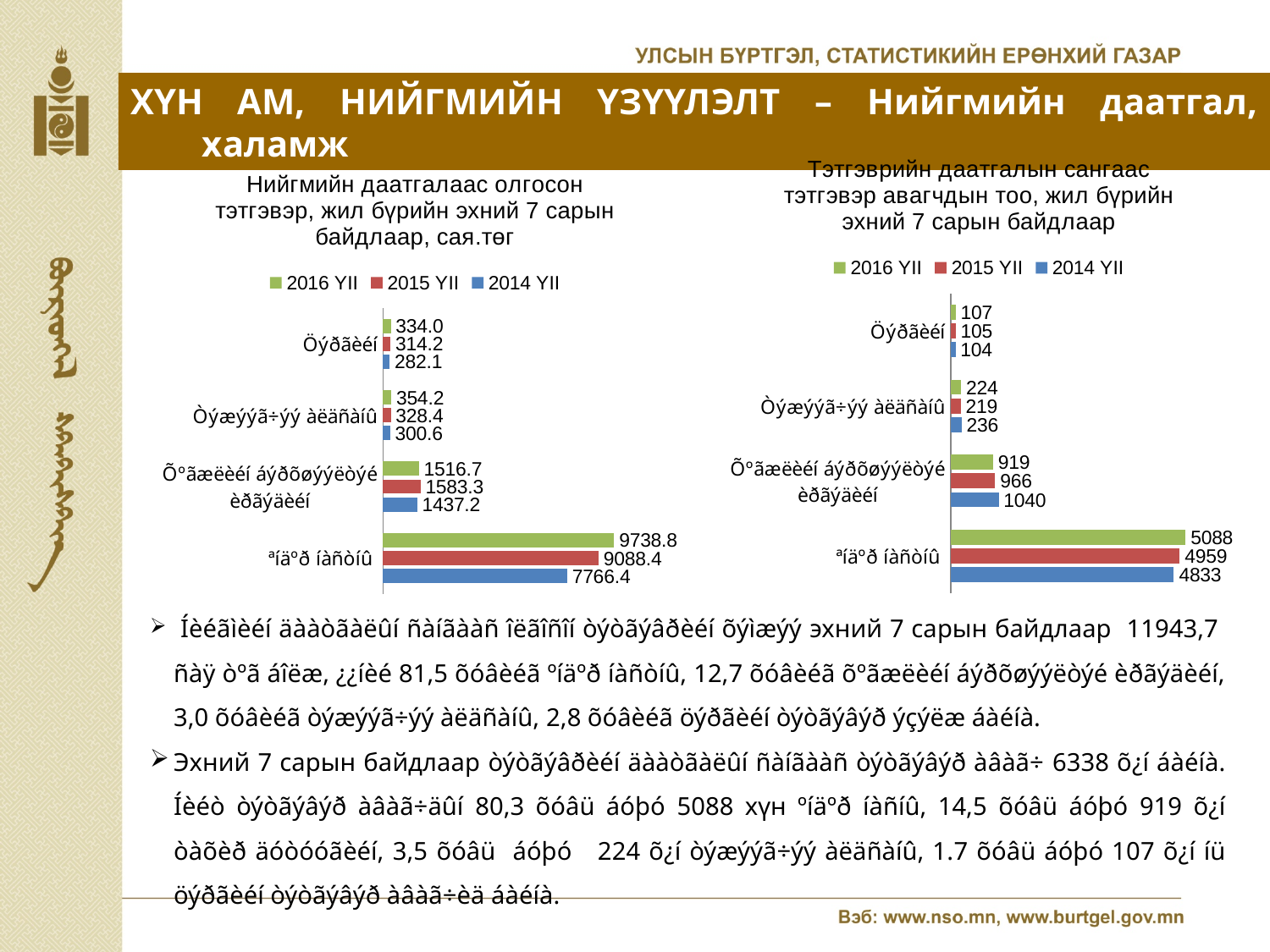
In the left chart (Нийгмийн даатгалаас олгосон тэтгэвэр), for the third category from the top, which is larger: the 2015 YII value or the 2016 YII value? 2015 YII In the left chart (Нийгмийн даатгалаас олгосон тэтгэвэр), what is the 2014 YII value for the top category? 282.1 How many categories are shown in the right chart (Тэтгэврийн даатгалын сангаас тэтгэвэр авагчдын тоо)? 4 In the right chart (Тэтгэврийн даатгалын сангаас тэтгэвэр авагчдын тоо), what is the 2014 YII value for the third category from the top? 1040 In the left chart (Нийгмийн даатгалаас олгосон тэтгэвэр), which series has the highest value for the bottom category? 2016 YII How many series does the legend of the right chart (Тэтгэврийн даатгалын сангаас тэтгэвэр авагчдын тоо) list? 3 What kind of chart is the left chart (Нийгмийн даатгалаас олгосон тэтгэвэр)? Bar chart In the right chart (Тэтгэврийн даатгалын сангаас тэтгэвэр авагчдын тоо), what is the difference between the 2016 YII and 2014 YII values for the bottom category? 255 In the left chart (Нийгмийн даатгалаас олгосон тэтгэвэр), what is the difference between the 2016 YII and 2015 YII values for the bottom category? 650.4 In the right chart (Тэтгэврийн даатгалын сангаас тэтгэвэр авагчдын тоо), what is the 2015 YII value for the bottom category? 4959 In the left chart (Нийгмийн даатгалаас олгосон тэтгэвэр), what is the 2016 YII value for the bottom category? 9738.8 In the right chart (Тэтгэврийн даатгалын сангаас тэтгэвэр авагчдын тоо), which series has the lowest value for the second category from the top? 2015 YII